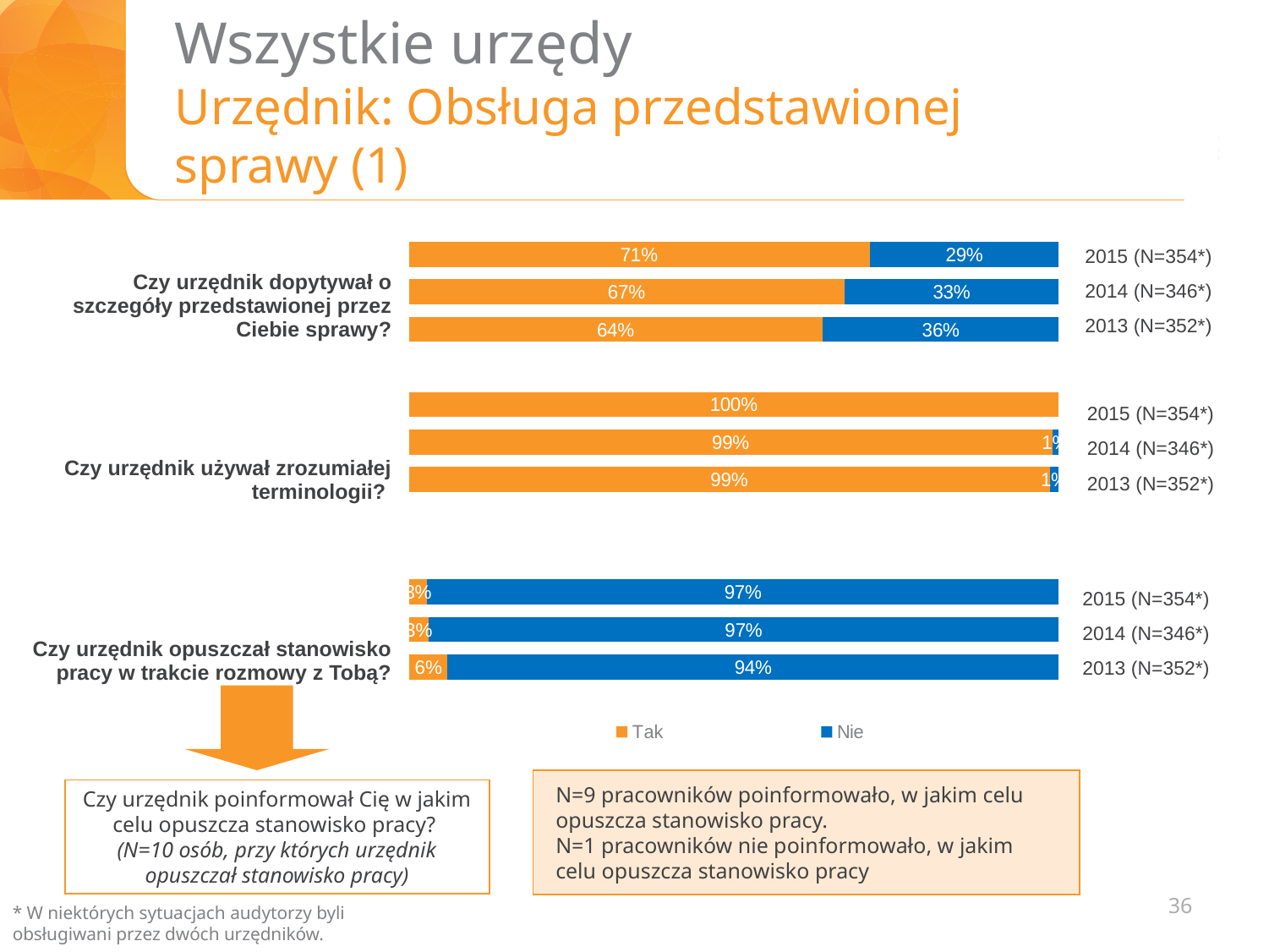
In the chart for "Czy urzędnik dopytywał o szczegóły przedstawionej przez Ciebie sprawy?", which year has the highest "Tak" share? 2015 (N=354*) In the chart for "Czy urzędnik dopytywał o szczegóły przedstawionej przez Ciebie sprawy?", does the "Tak" share rise or fall from 2013 to 2015? rise How many series does the legend list for the charts on this slide? 2 What type of chart is used on this slide? Stacked bar chart In the chart for "Czy urzędnik dopytywał o szczegóły przedstawionej przez Ciebie sprawy?", what is the "Tak" value for 2015 (N=354*)? 71% In the chart for "Czy urzędnik opuszczał stanowisko pracy w trakcie rozmowy z Tobą?", what is the "Nie" value for 2013 (N=352*)? 94% In the chart for "Czy urzędnik dopytywał o szczegóły przedstawionej przez Ciebie sprawy?", what is the "Nie" value for 2013 (N=352*)? 36% In the chart for "Czy urzędnik opuszczał stanowisko pracy w trakcie rozmowy z Tobą?", what is the "Tak" value for 2013 (N=352*)? 6% In the chart for "Czy urzędnik używał zrozumiałej terminologii?", what is the "Tak" value for 2015 (N=354*)? 100% In the chart for "Czy urzędnik używał zrozumiałej terminologii?", what is the "Tak" value for 2014 (N=346*)? 99% In the chart for "Czy urzędnik dopytywał o szczegóły przedstawionej przez Ciebie sprawy?", what is the difference between the "Tak" values for 2015 and 2013? 7 percentage points In the chart for "Czy urzędnik opuszczał stanowisko pracy w trakcie rozmowy z Tobą?", which is larger for 2015: the "Tak" share or the "Nie" share? Nie